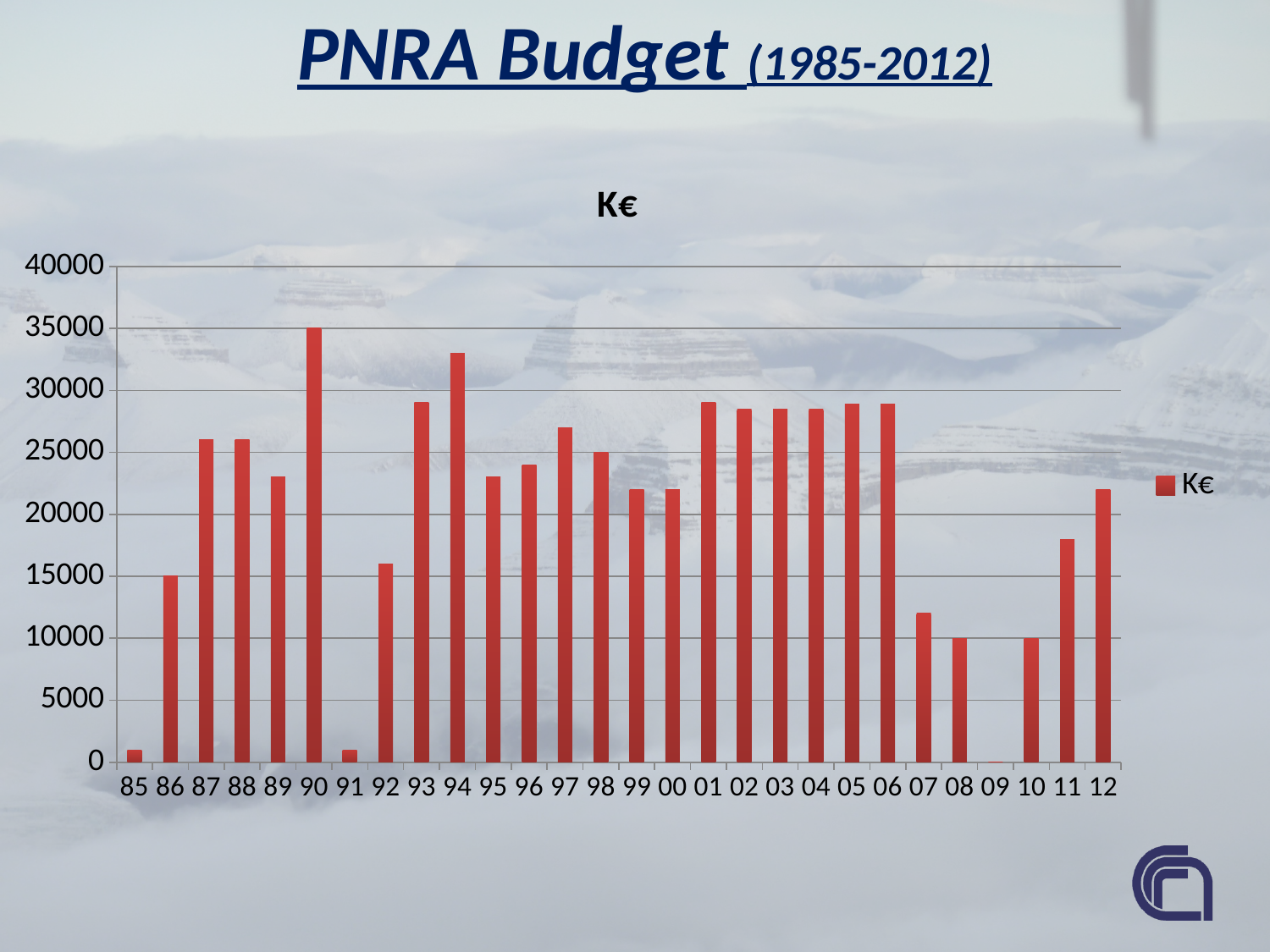
Which year has the lowest budget? 09 Which year has the larger budget, 87 or 89? 87 Which year has the highest budget? 90 Is the value for 11 greater or less than 20000? less Is the value for 85 greater or less than 5000? less What kind of chart is shown on the slide? bar chart What is the budget value for 90 in K€? 35000 Is the value for 94 greater or less than 30000? greater Do the values rise or fall from 09 to 12? rise How many series does the legend list? 1 How many years (categories) are plotted on the x axis? 28 What is the budget value for 08 in K€? 10000